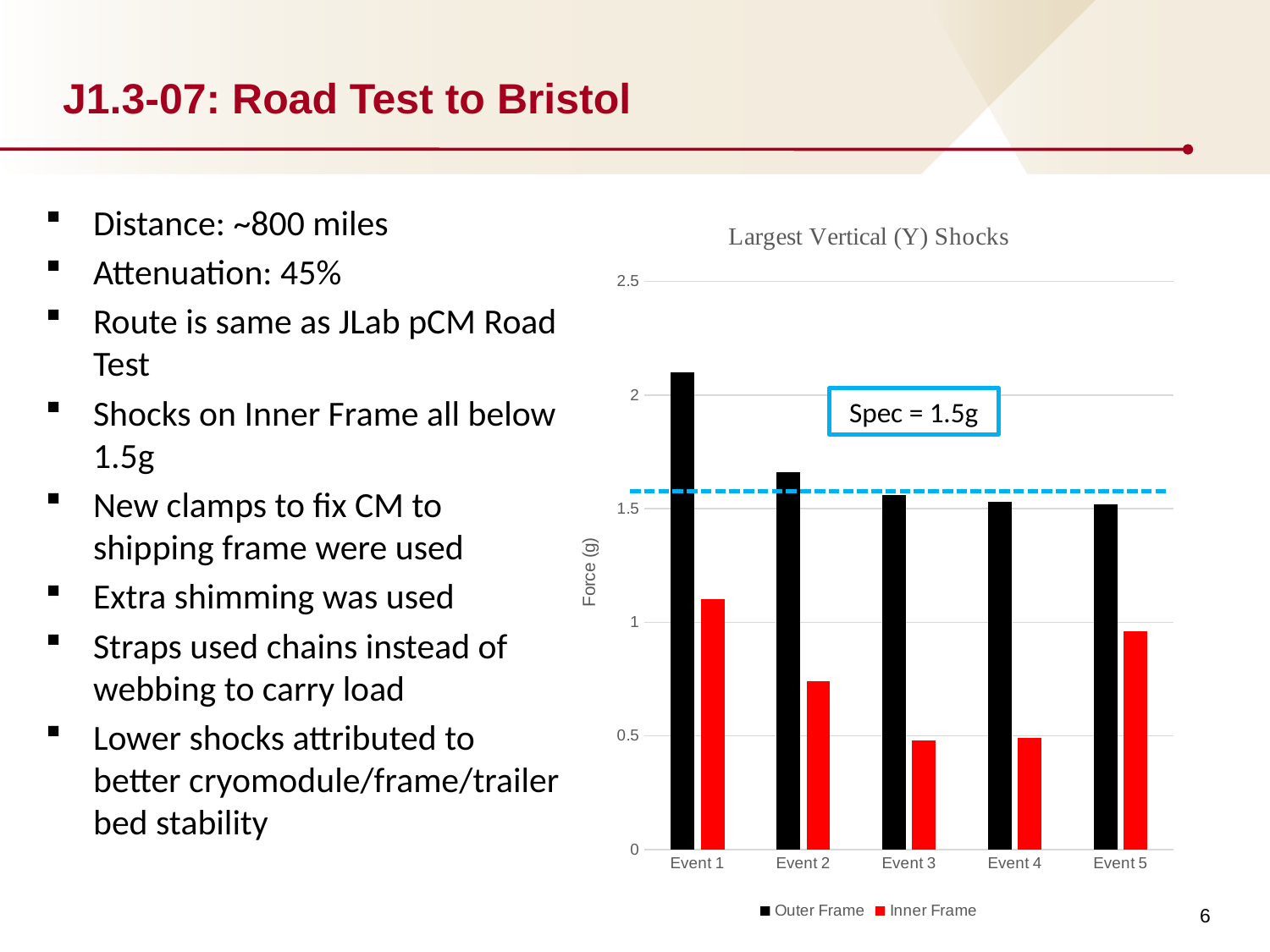
Which is larger for Event 1, the Outer Frame value or the Inner Frame value? Outer Frame Which is larger, the Inner Frame value for Event 5 or the Inner Frame value for Event 2? Event 5 What type of chart is shown on the slide? Bar chart Is the Inner Frame value for Event 1 greater or less than 1? greater Which event has the highest Inner Frame value? Event 1 What is the title of the chart? Largest Vertical (Y) Shocks How many series does the chart legend list? 2 How many events are shown on the x axis of the chart? 5 Is the Outer Frame value for Event 1 greater or less than 2? greater Is the Inner Frame value for Event 2 greater or less than 1? less Which event has the highest Outer Frame value? Event 1 Do the Outer Frame values rise or fall from Event 1 to Event 5? Fall